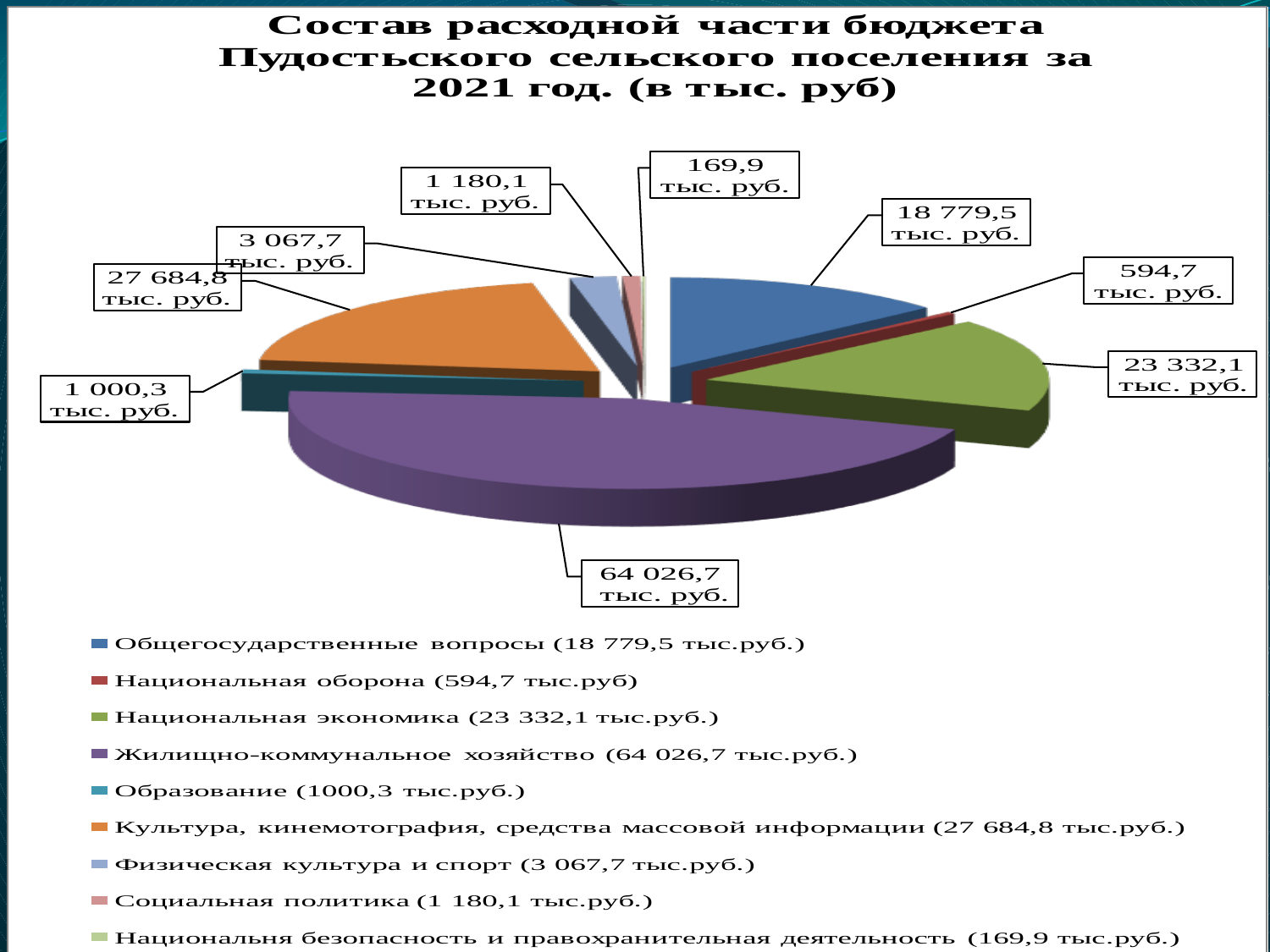
What is the value of the slice for Национальная оборона? 594,7 тыс. руб. What year does the chart title say the budget expenditure data is for? 2021 Which category has the largest slice of the pie? Жилищно-коммунальное хозяйство What is the difference between the values for Жилищно-коммунальное хозяйство and Культура, кинемотография, средства массовой информации? 36 341,9 тыс. руб. What is the value of the slice for Культура, кинемотография, средства массовой информации? 27 684,8 тыс. руб. What kind of chart is shown on the slide? Pie chart What is the difference between the values for Национальная экономика and Общегосударственные вопросы? 4 552,6 тыс. руб. How many slices (categories) does the pie chart have? 9 Which category has the smallest slice of the pie? Национальня безопасность и правохранительная деятельность What is the value of the slice for Национальная экономика? 23 332,1 тыс. руб. What is the value of the slice for Жилищно-коммунальное хозяйство? 64 026,7 тыс. руб. Which is larger: the slice for Национальная экономика or the slice for Общегосударственные вопросы? Национальная экономика